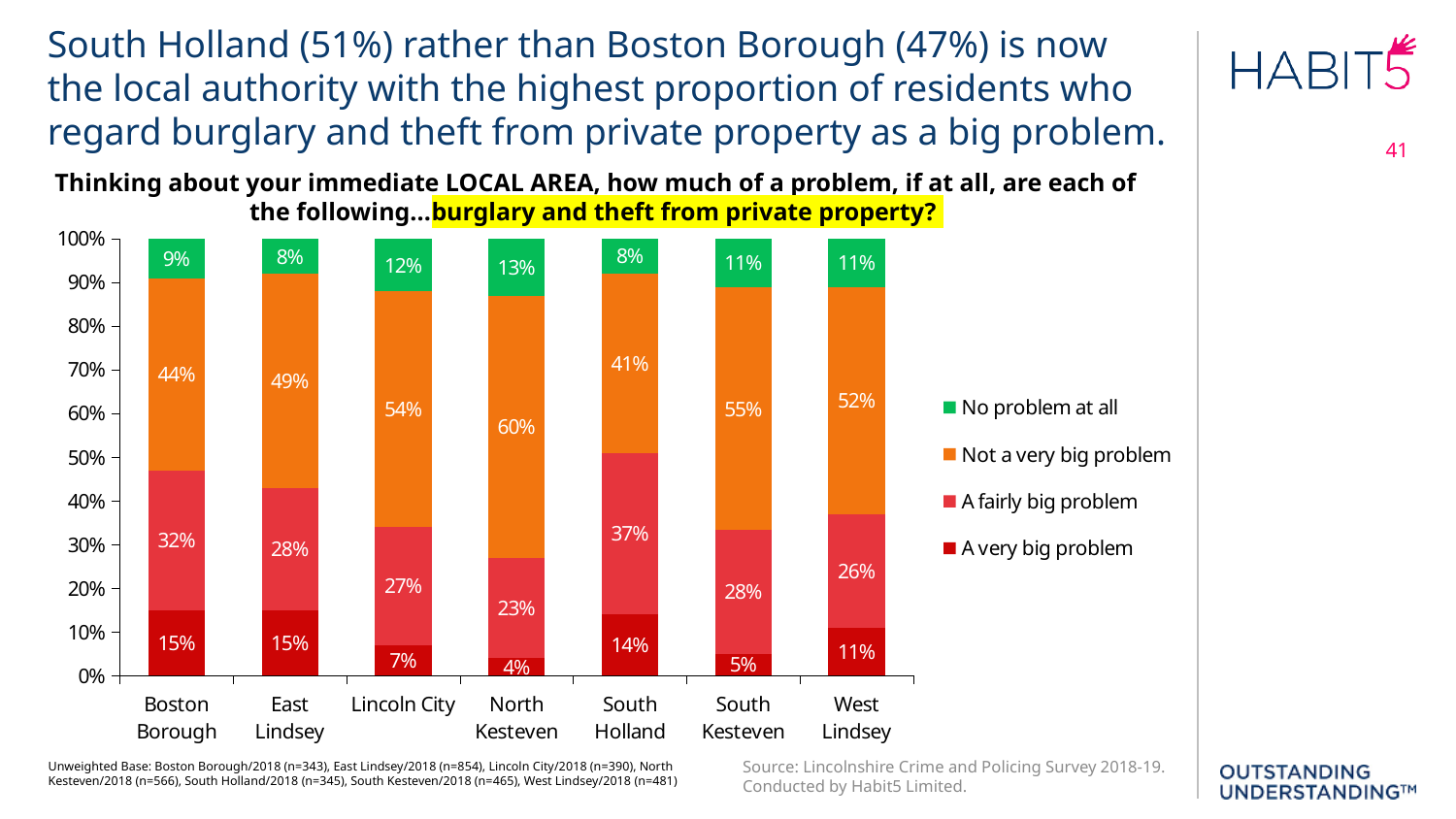
Which local authority has the lowest 'A very big problem' value? North Kesteven How many series does the legend list? 4 What is the difference between the 'Not a very big problem' values for North Kesteven and Boston Borough? 16 percentage points Which local authority has the highest 'A fairly big problem' value? South Holland What kind of chart is shown on the slide? Stacked bar chart Which local authority has the highest 'Not a very big problem' value? North Kesteven What is the 'Not a very big problem' value for North Kesteven? 60% How many local authorities are shown on the x axis? 7 What percentage of South Holland residents regard burglary and theft from private property as 'A very big problem'? 14% What is the combined total of 'A very big problem' and 'A fairly big problem' for Boston Borough? 47% What is the 'No problem at all' value for Lincoln City? 12% Which has the larger 'A fairly big problem' value, Boston Borough or East Lindsey? Boston Borough